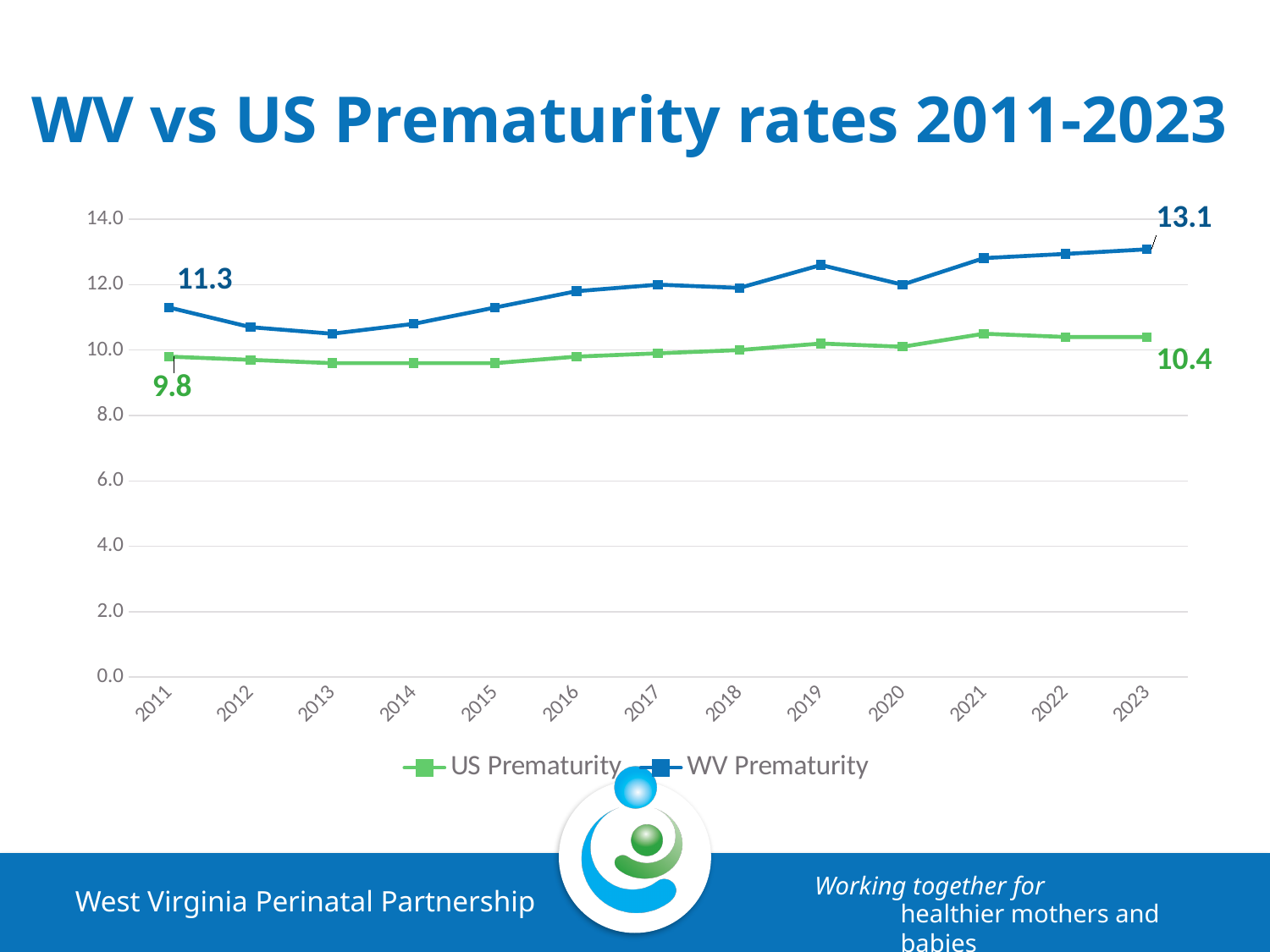
What is the WV Prematurity rate in 2011? 11.3 What is the US Prematurity rate in 2011? 9.8 How many series does the legend list? 2 How many years are plotted on the x axis? 13 What is the US Prematurity rate in 2023? 10.4 By how much did the WV Prematurity rate increase from 2011 to 2023? 1.8 In 2023, which series has the higher value, WV Prematurity or US Prematurity? WV Prematurity Is the WV Prematurity value for 2019 greater or less than 12.0? greater What is the WV Prematurity rate in 2023? 13.1 What is the difference between the WV and US Prematurity rates in 2023? 2.7 What kind of chart is shown on the slide? line chart Is the US Prematurity value for 2013 greater or less than 10.0? less